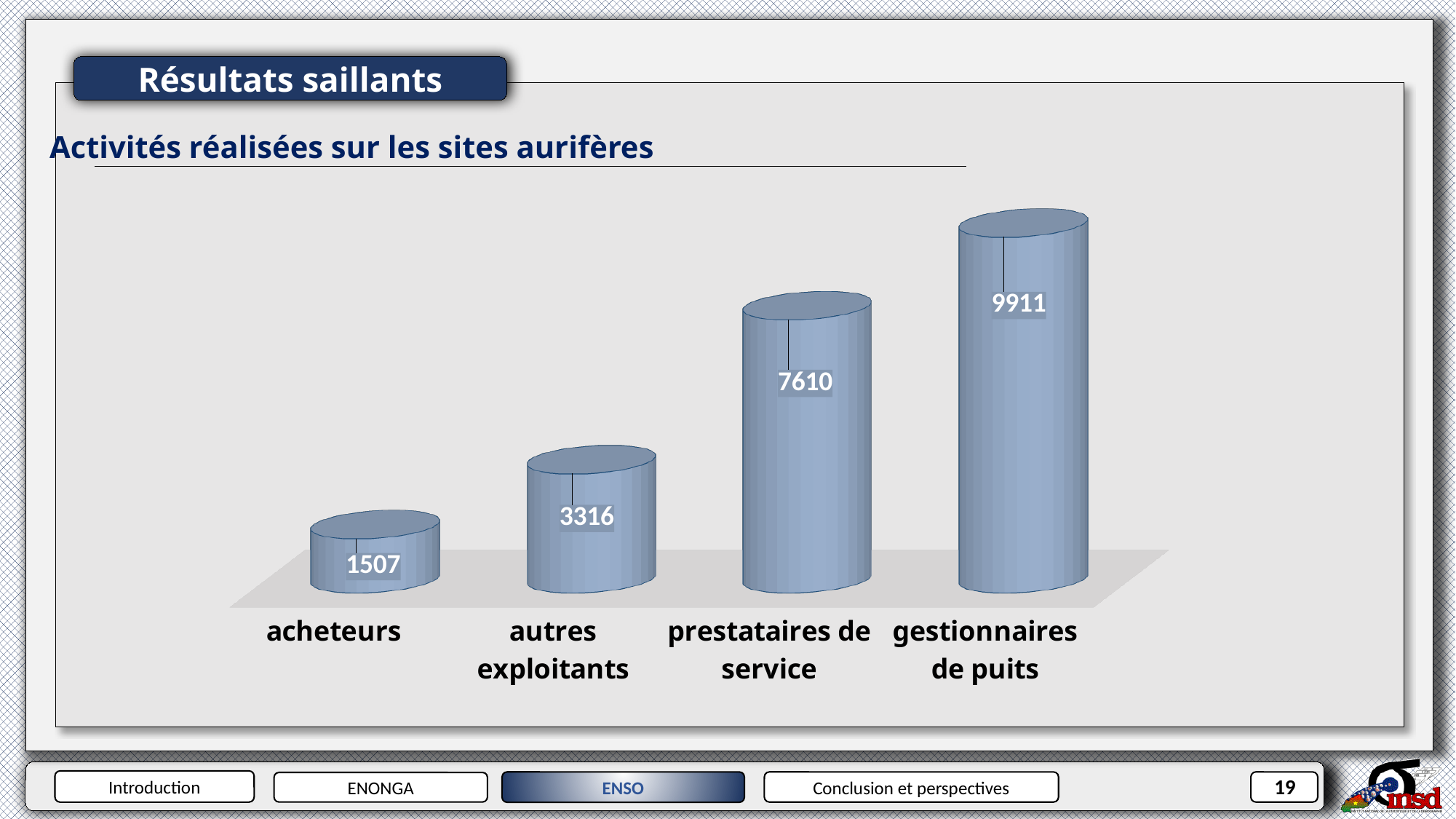
What is the value for gestionnaires de puits? 9911 What kind of chart is shown on the slide? bar chart Do the values rise or fall from left to right along the x axis? rise What is the value for autres exploitants? 3316 Which category has the highest value? gestionnaires de puits Which is larger, the value for prestataires de service or the value for autres exploitants? prestataires de service Which category has the lowest value? acheteurs What is the difference between the values for gestionnaires de puits and prestataires de service? 2301 What is the difference between the values for autres exploitants and acheteurs? 1809 What is the value for acheteurs? 1507 How many categories are shown in the chart? 4 What is the value for prestataires de service? 7610